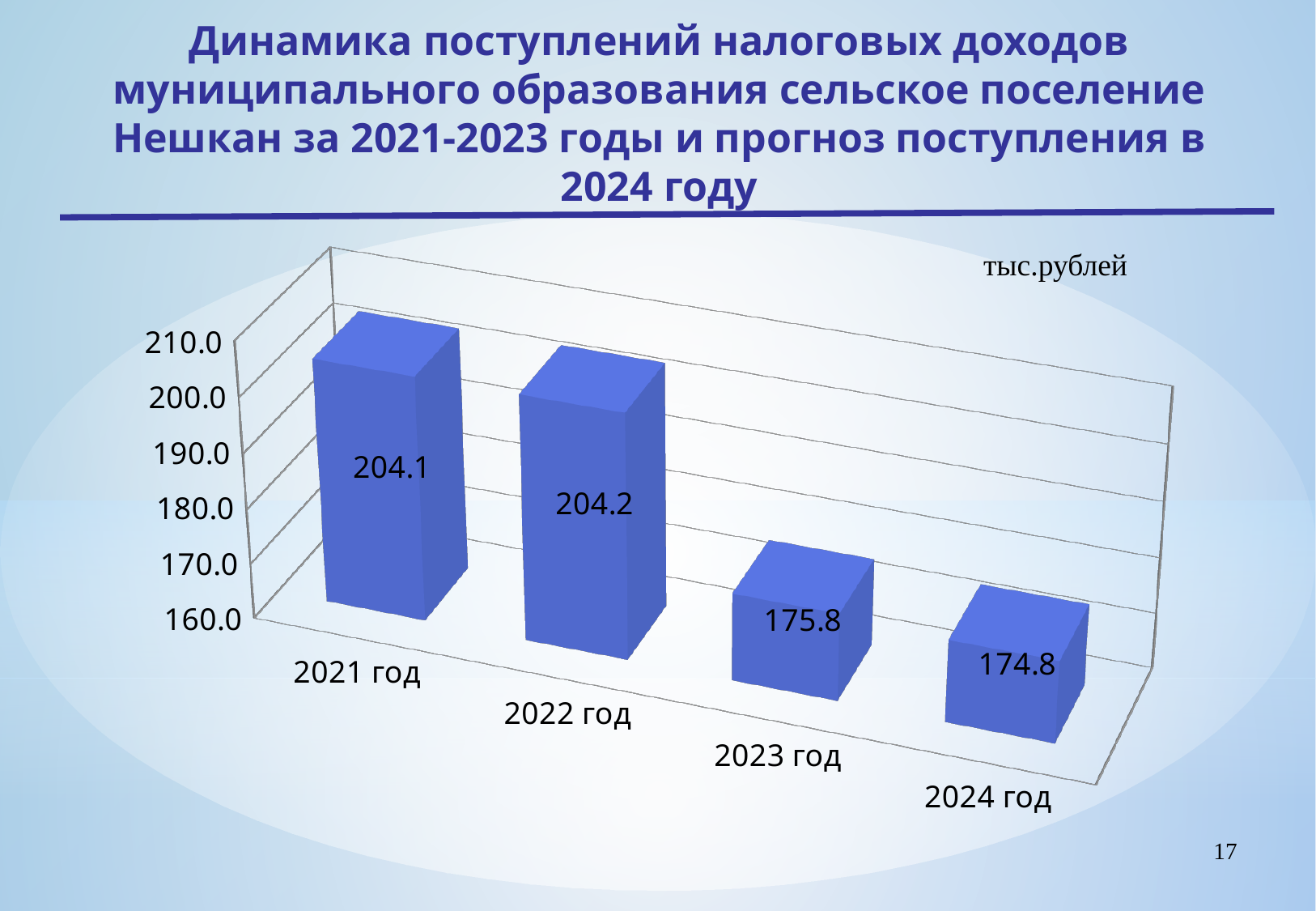
What is the value for 2021 год? 204.1 Is the value for 2021 год greater or less than 200.0? greater What is the difference between the values for 2021 год and 2024 год? 29.3 What is the forecast value for 2024 год? 174.8 What is the value for 2023 год? 175.8 What kind of chart is shown on the slide? bar chart Is the value for 2023 год greater or less than 180.0? less Which is larger, the value for 2021 год or the value for 2023 год? 2021 год In what units are the values on the chart expressed? тыс.рублей How many years (categories) are shown on the chart? 4 What is the value for 2022 год? 204.2 What is the difference between the values for 2022 год and 2023 год? 28.4